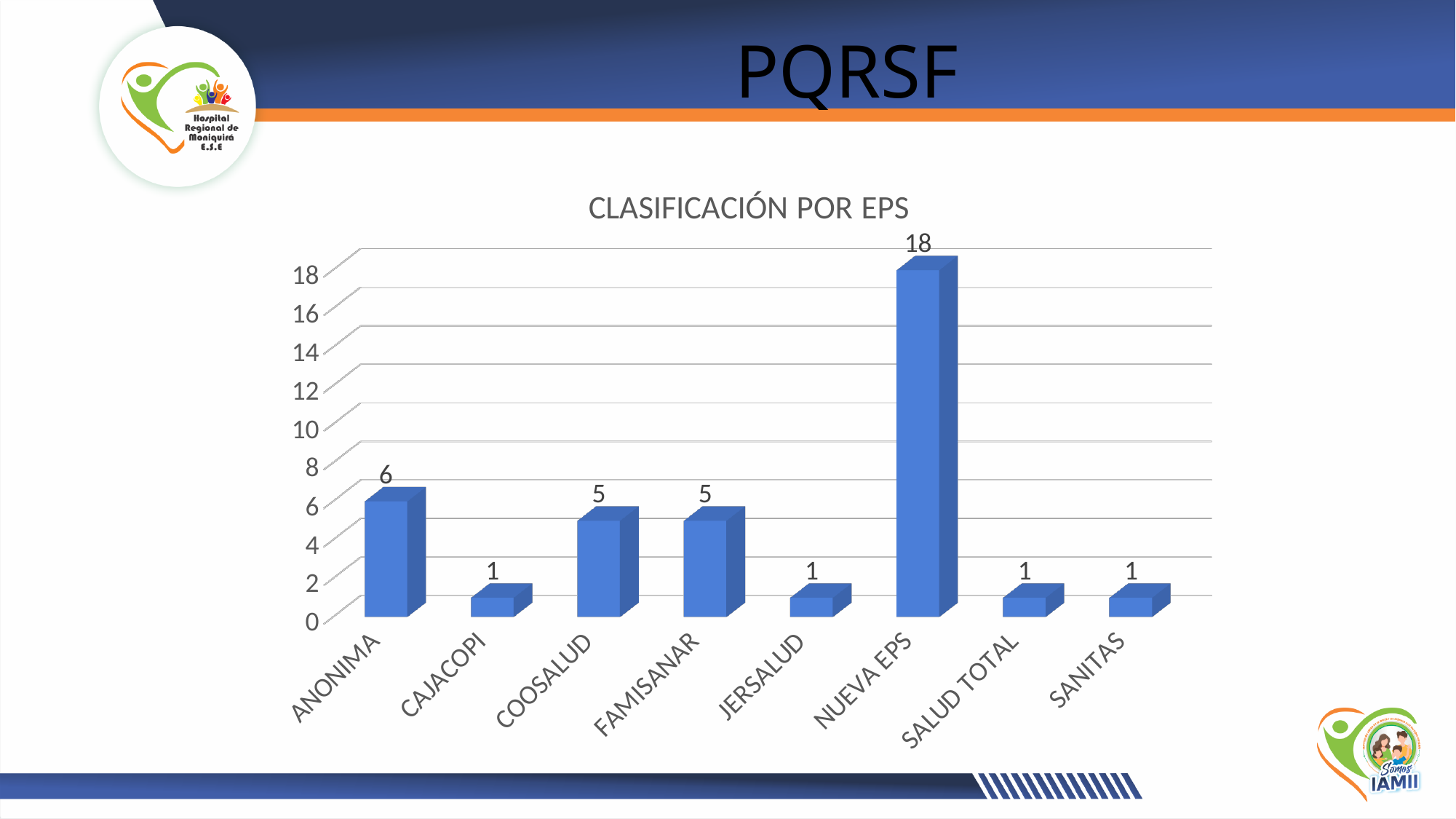
What is the difference between the values for ANONIMA and FAMISANAR? 1 What kind of chart is shown on the slide? bar chart Which category has the highest value? NUEVA EPS Is the value for NUEVA EPS greater or less than 10? greater What is the difference between the values for NUEVA EPS and ANONIMA? 12 What is the value for NUEVA EPS? 18 What is the value for JERSALUD? 1 Which is larger, the value for ANONIMA or the value for CAJACOPI? ANONIMA How many categories are shown on the x axis? 8 What is the value for COOSALUD? 5 What is the title of the chart? CLASIFICACIÓN POR EPS What is the value for ANONIMA? 6